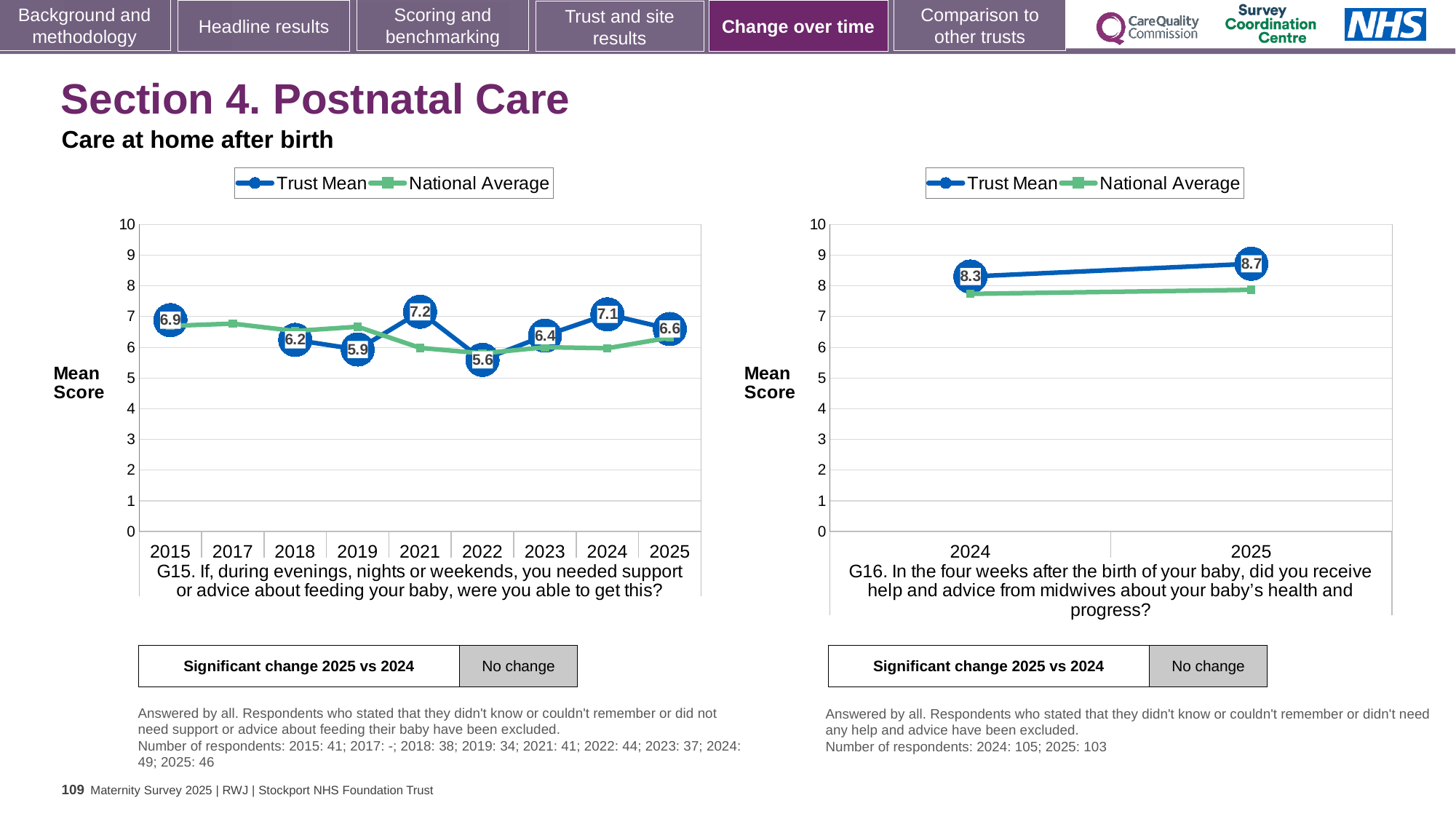
In the G15 chart on the left, what is the Trust Mean for 2025? 6.6 In the G16 chart on the right, does the Trust Mean rise or fall from 2024 to 2025? rise How many series does the legend of the G16 chart on the right list? 2 In the G16 chart on the right, is the National Average for 2025 greater or less than 8? less In the G15 chart on the left, what is the difference between the Trust Mean for 2024 and 2025? 0.5 In the G15 chart on the left, which year has the lowest Trust Mean? 2022 In the G15 chart on the left, what is the Trust Mean for 2022? 5.6 In the G15 chart on the left, is the National Average for 2017 greater or less than 6? greater In the G16 chart on the right, what is the Trust Mean for 2024? 8.3 In the G15 chart on the left, which year has the highest Trust Mean? 2021 In the G15 chart on the left, is the Trust Mean higher in 2018 or 2019? 2018 In the G16 chart on the right, what is the difference between the Trust Mean for 2025 and 2024? 0.4